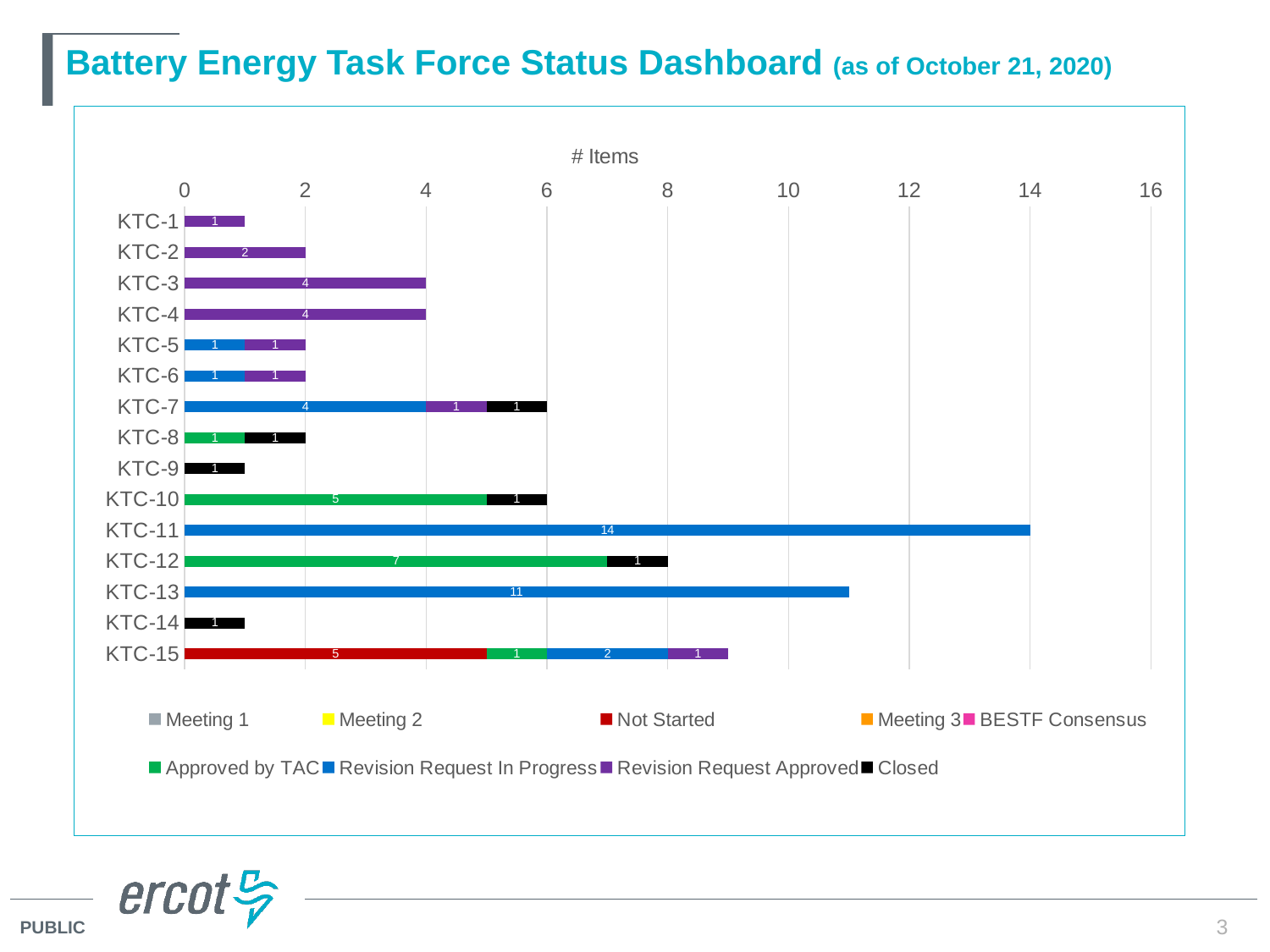
What is the title of the horizontal axis? # Items What is the total number of items for KTC-15? 9 Which has a larger Approved by TAC value, KTC-10 or KTC-12? KTC-12 What is the Not Started value for KTC-15? 5 How many series does the legend list? 9 What is the Revision Request In Progress value for KTC-11? 14 Which KTC has the longest total bar? KTC-11 What is the Approved by TAC value for KTC-12? 7 What is the difference between the Revision Request In Progress values for KTC-11 and KTC-13? 3 How many KTC categories are plotted on the chart? 15 What kind of chart is shown on the slide? Stacked bar chart What is the total number of items for KTC-7? 6